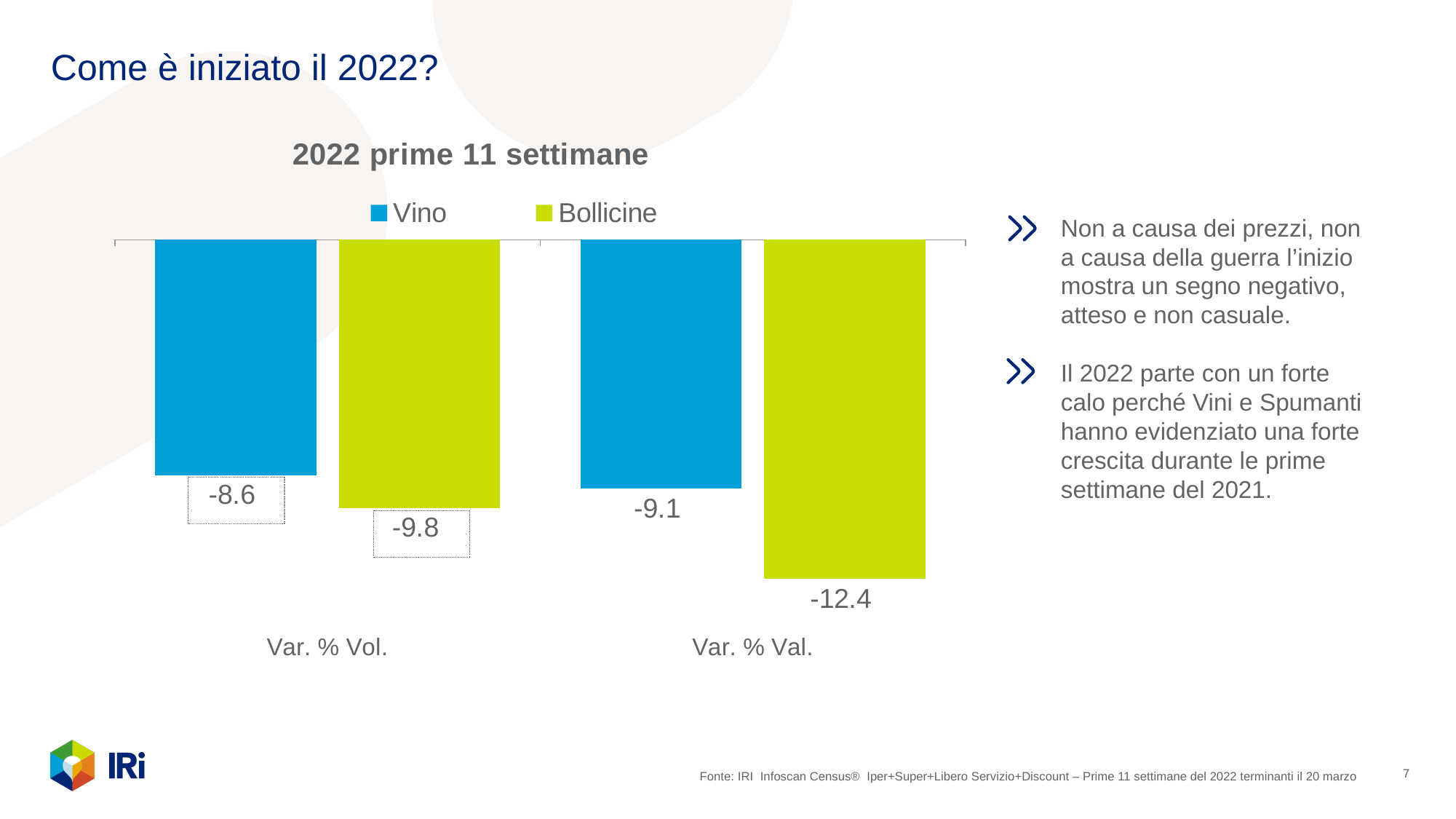
What is the value for Vino in the Var. % Vol. category? -8.6 How many categories are shown on the x axis? 2 What is the value for Vino in the Var. % Val. category? -9.1 Which is larger, the Vino value for Var. % Vol. or the Vino value for Var. % Val.? Var. % Vol. How many series does the legend list? 2 What is the value for Bollicine in the Var. % Val. category? -12.4 What is the title of the chart? 2022 prime 11 settimane Which series and category combination has the lowest value on the chart? Bollicine, Var. % Val. What is the difference between the Vino and Bollicine values in the Var. % Vol. category? 1.2 What is the difference between the Vino and Bollicine values in the Var. % Val. category? 3.3 Which series and category combination has the highest value on the chart? Vino, Var. % Vol. What is the value for Bollicine in the Var. % Vol. category? -9.8